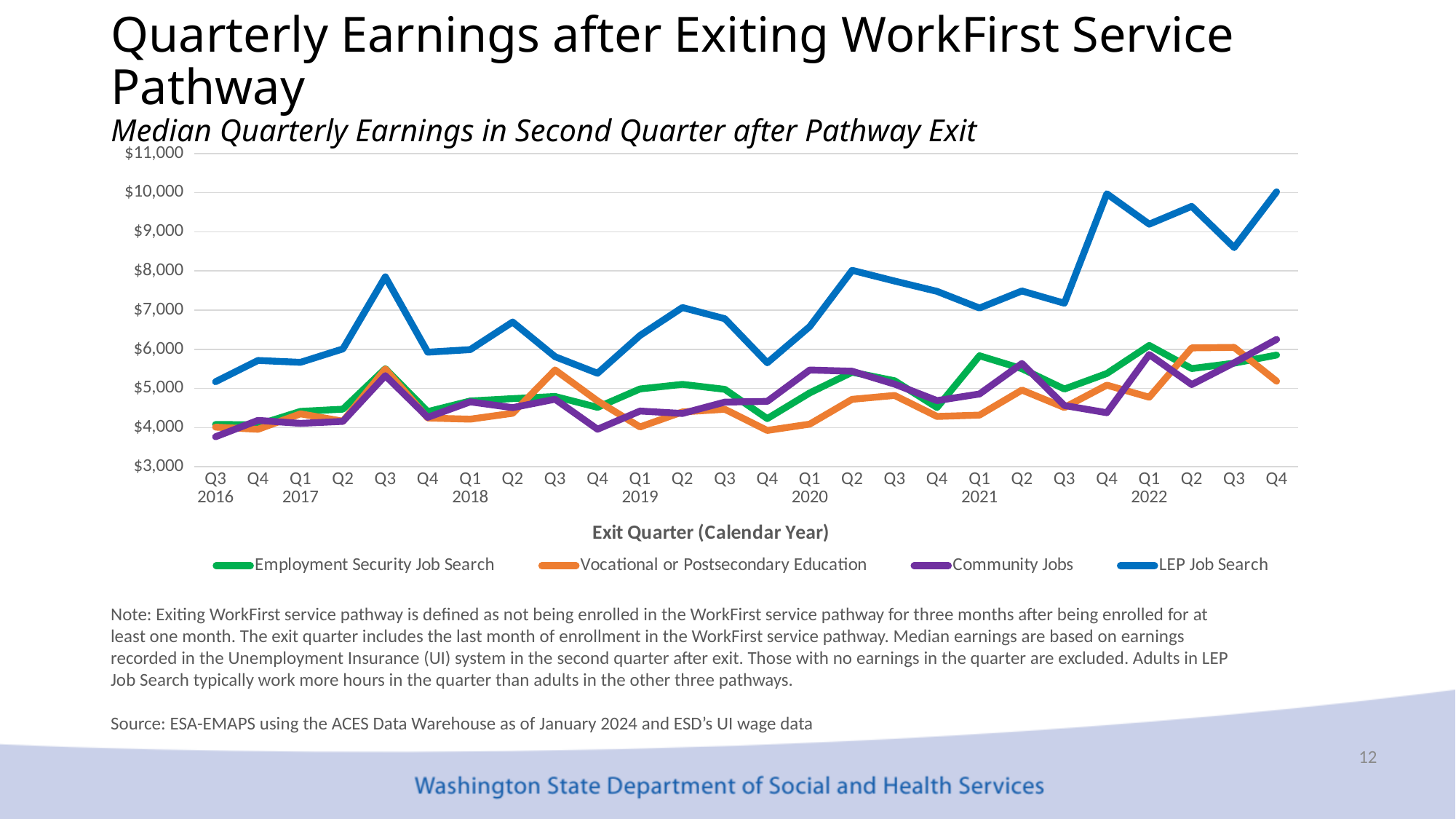
Is the value for Community Jobs in Q3 2016 greater or less than $4,000? less Is the value for Vocational or Postsecondary Education in Q4 2022 greater or less than $6,000? less How many series does the legend list? 4 What kind of chart is shown on the slide? line chart Is the value for LEP Job Search in Q3 2016 greater or less than $6,000? less How many exit quarters are plotted along the x axis? 26 Which pathway has the lowest median quarterly earnings in Q3 2016? Community Jobs What is the title of the x axis? Exit Quarter (Calendar Year) In Q2 2020, which is higher: LEP Job Search or Employment Security Job Search? LEP Job Search Which pathway has the highest median quarterly earnings in Q4 2022? LEP Job Search